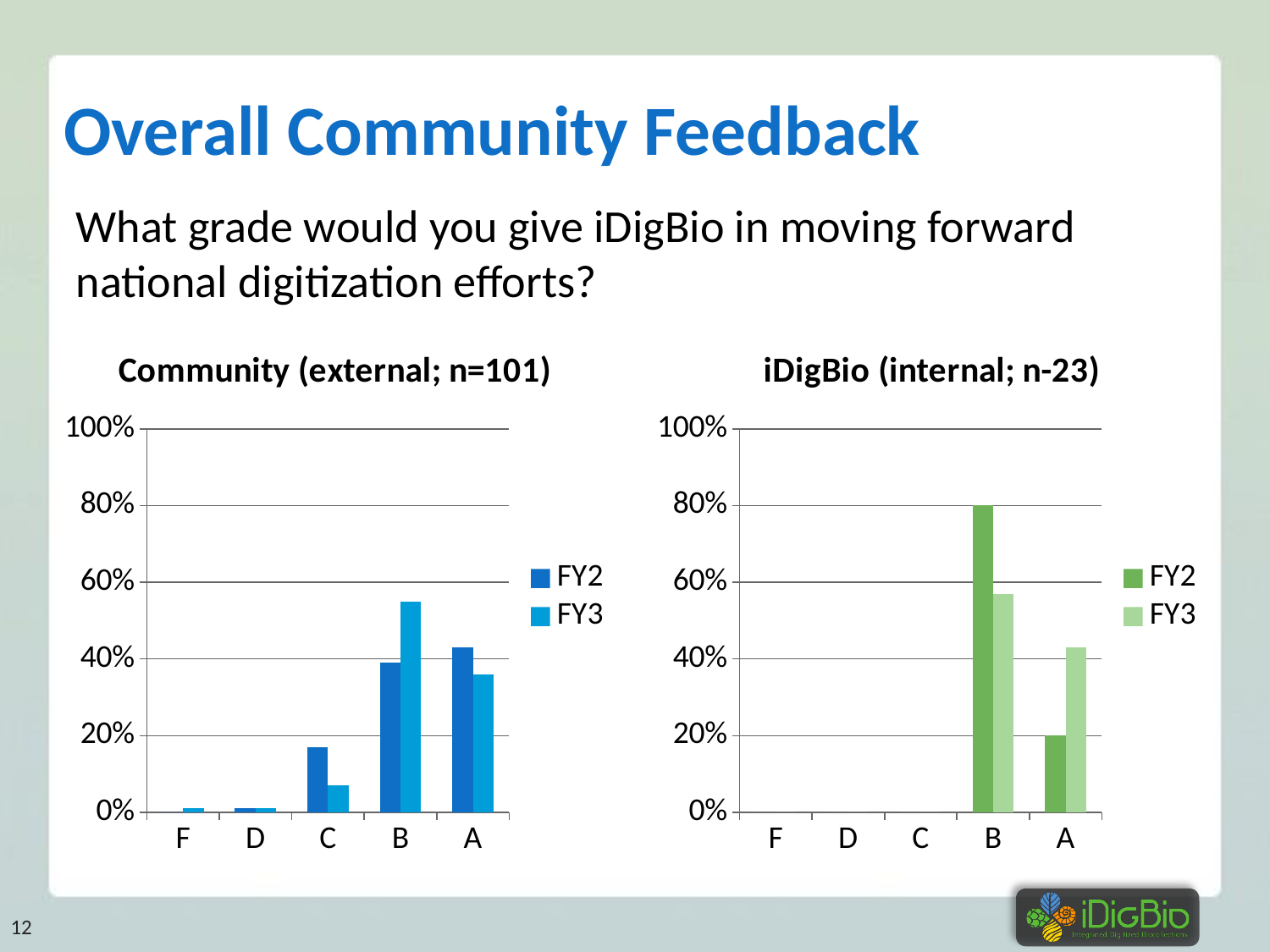
In the 'iDigBio (internal; n-23)' chart, what is the FY2 value for grade A? 20% In the 'iDigBio (internal; n-23)' chart, which is larger for grade A, FY2 or FY3? FY3 In the 'Community (external; n=101)' chart, is the FY3 value for B greater or less than 40%? greater How many series does the legend of the 'iDigBio (internal; n-23)' chart list? 2 What kind of chart is the 'Community (external; n=101)' chart? bar chart How many grade categories are shown on the x axis of the 'Community (external; n=101)' chart? 5 In the 'Community (external; n=101)' chart, which grade has the highest FY2 value? A In the 'iDigBio (internal; n-23)' chart, what is the FY2 value for grade B? 80% In the 'Community (external; n=101)' chart, which grade has the highest FY3 value? B In the 'Community (external; n=101)' chart, which is larger for grade A, FY2 or FY3? FY2 What are the two legend entries in the 'Community (external; n=101)' chart? FY2 and FY3 In the 'Community (external; n=101)' chart, is the FY2 value for C greater or less than 20%? less